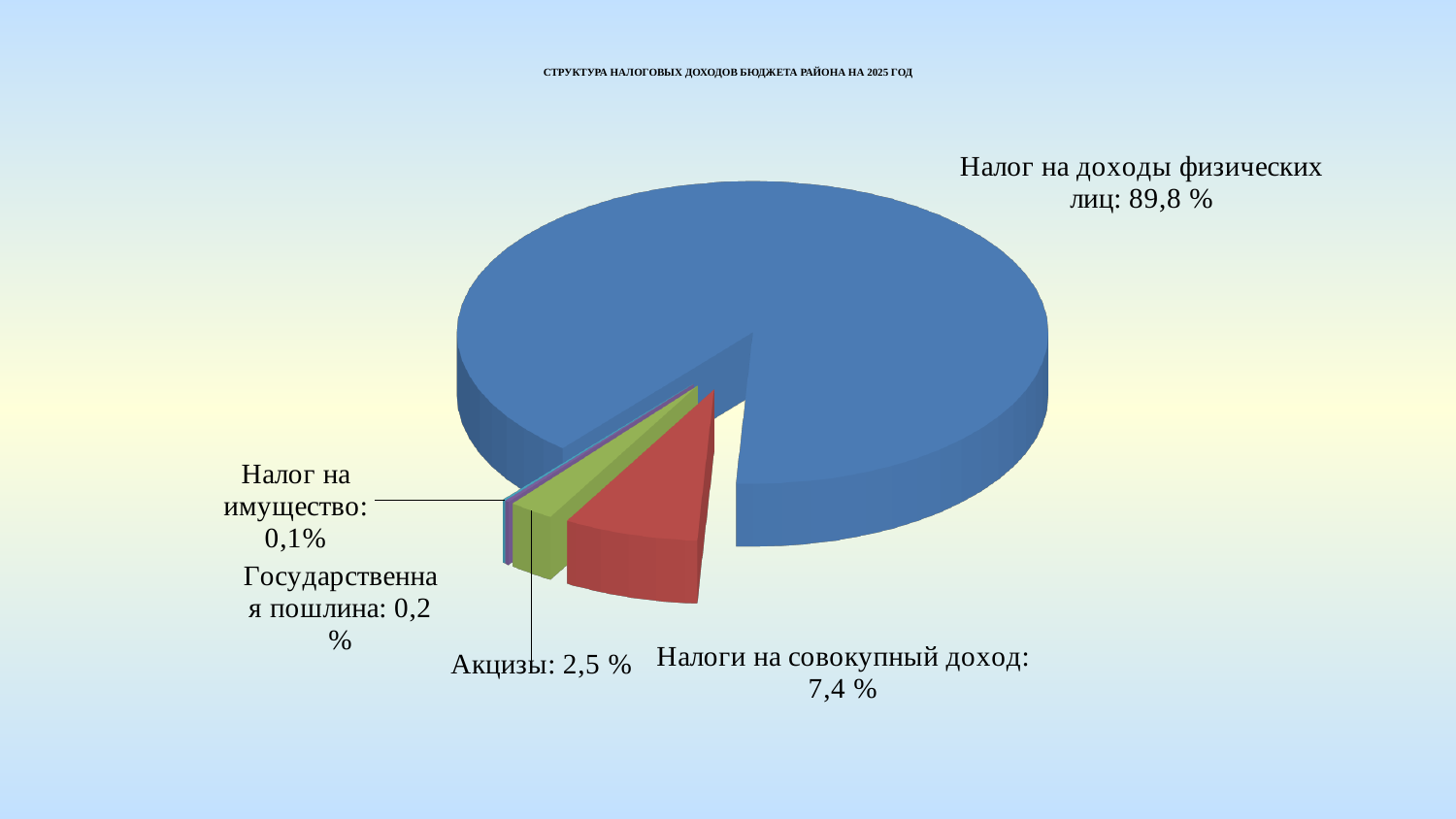
Какова доля акцизов? 2,5 % Какой тип диаграммы показан на слайде? Круговая диаграмма Какова доля государственной пошлины? 0,2 % Какая категория имеет наименьшую долю в структуре налоговых доходов? Налог на имущество Какова доля налогов на совокупный доход? 7,4 % Какова доля налога на доходы физических лиц в структуре налоговых доходов бюджета района на 2025 год? 89,8 % Сколько категорий (секторов) показано на круговой диаграмме? 5 Какова доля налога на имущество? 0,1% Каким цветом показан сектор налога на доходы физических лиц? Синим Что больше: доля акцизов или доля государственной пошлины? Акцизы Какая категория имеет наибольшую долю в структуре налоговых доходов? Налог на доходы физических лиц На сколько процентных пунктов доля налогов на совокупный доход больше доли акцизов? 4,9